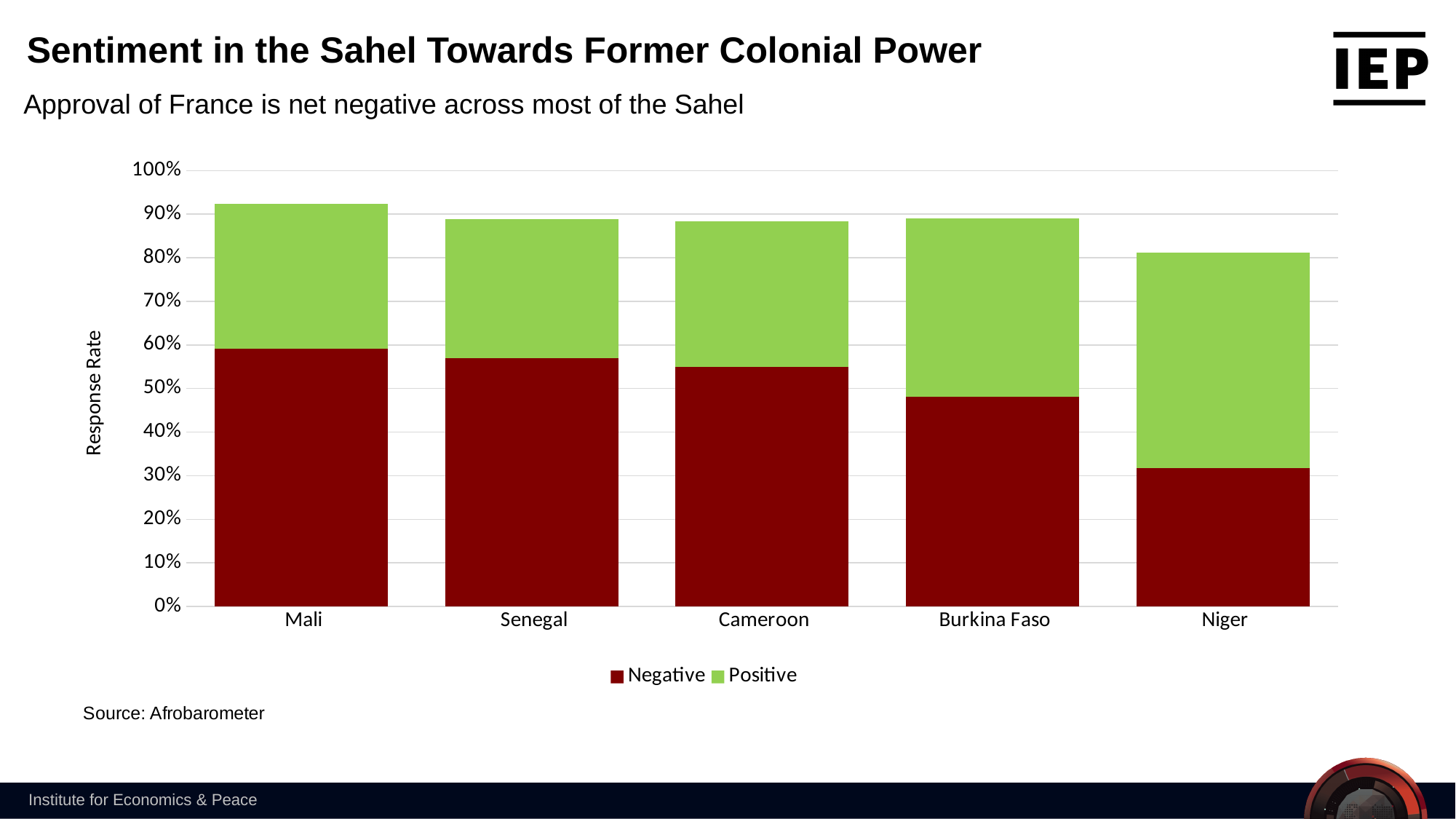
Do the Negative response rates rise or fall moving from Mali to Niger along the x axis? fall Is the Negative response rate for Mali greater or less than 50%? greater Which country has the lowest Negative response rate? Niger How many countries are shown on the x axis of the chart? 5 Which country has the shortest total stacked bar? Niger Which country has the largest Positive response rate? Niger Which country has the tallest total stacked bar? Mali Which is larger, the Negative response rate for Mali or for Niger? Mali What kind of chart is shown on the slide? Stacked bar chart Is the Negative response rate for Cameroon greater or less than 50%? greater Is the Negative response rate for Niger greater or less than 40%? less How many series does the chart's legend list? 2